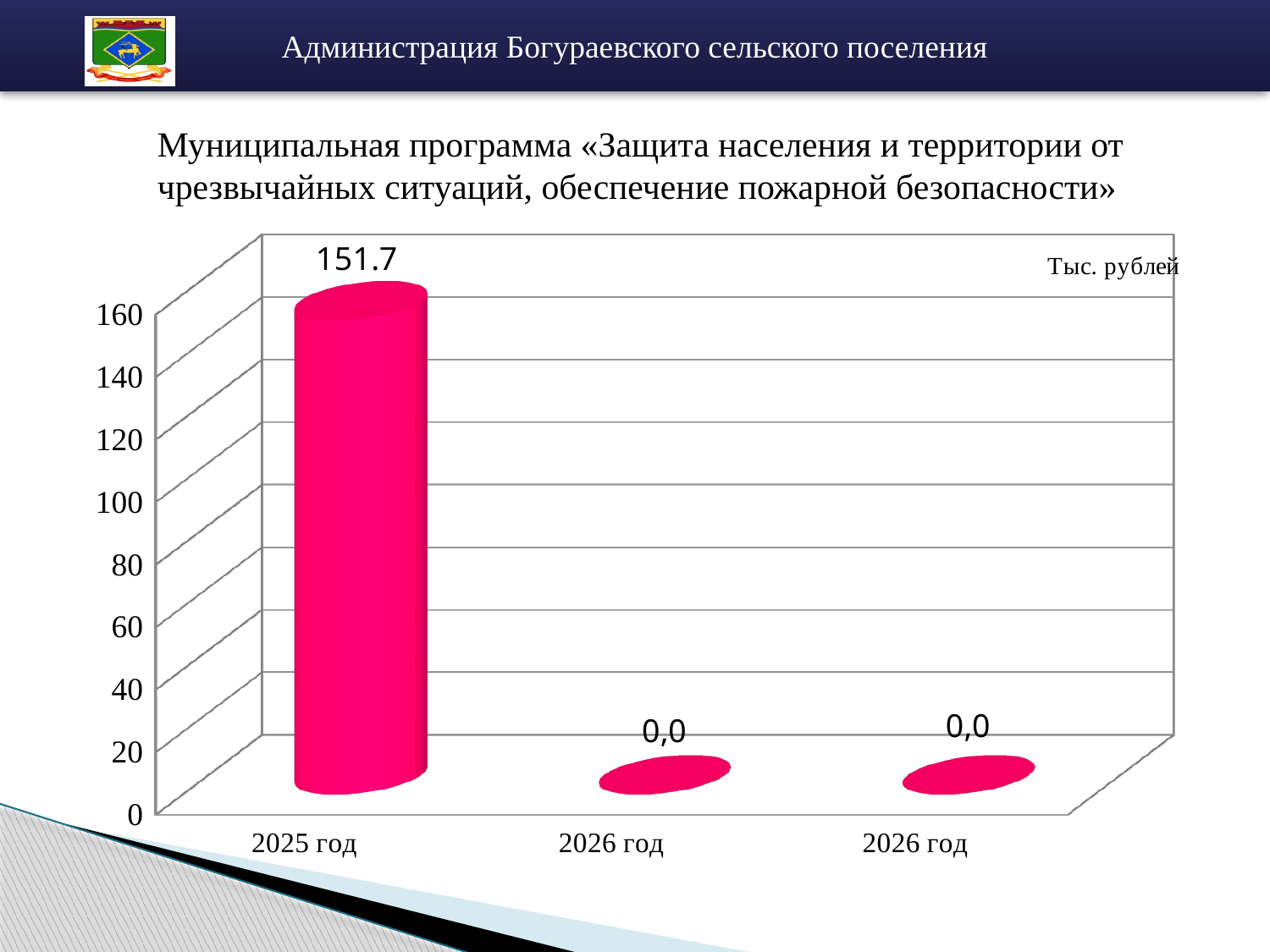
What is the difference between the value for 2025 год and the value for the middle bar (2026 год)? 151.7 What colour are the bars on the chart? pink What kind of chart is shown on the slide? bar chart Is the value for 2025 год greater or less than 160? less What is the value shown for the middle bar, labelled 2026 год? 0,0 How many bars are plotted on the chart? 3 What is the value for 2025 год? 151.7 Is the value for 2025 год greater or less than 140? greater What is the value shown for the rightmost bar? 0,0 What unit is indicated in the top right corner of the chart? Тыс. рублей Which category has the highest value? 2025 год Do the values rise or fall from the first bar to the last bar along the x axis? fall